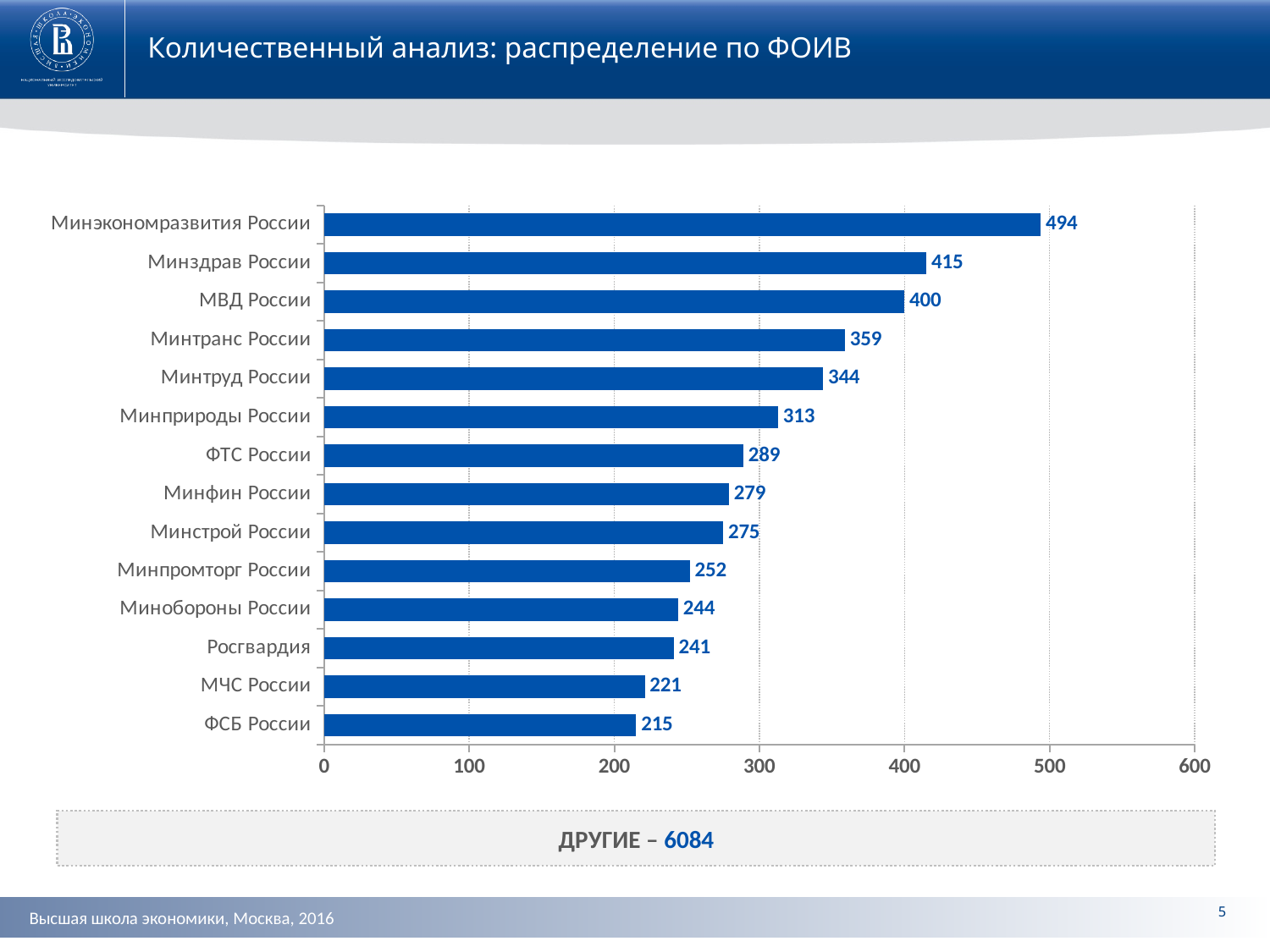
What is the difference between the values for Минэкономразвития России and ФСБ России? 279 What is the value for Росгвардия? 241 What is the value for ФТС России? 289 What is the value for Минэкономразвития России? 494 What is the maximum value shown on the horizontal axis? 600 Is the value for Минприроды России greater or less than 300? greater Which category has the highest value? Минэкономразвития России How many categories are shown in the chart? 14 What is the difference between the values for Минздрав России and МВД России? 15 Which category has the lowest value? ФСБ России Which is larger, the value for Минтранс России or the value for Минтруд России? Минтранс России What kind of chart is shown on the slide? bar chart